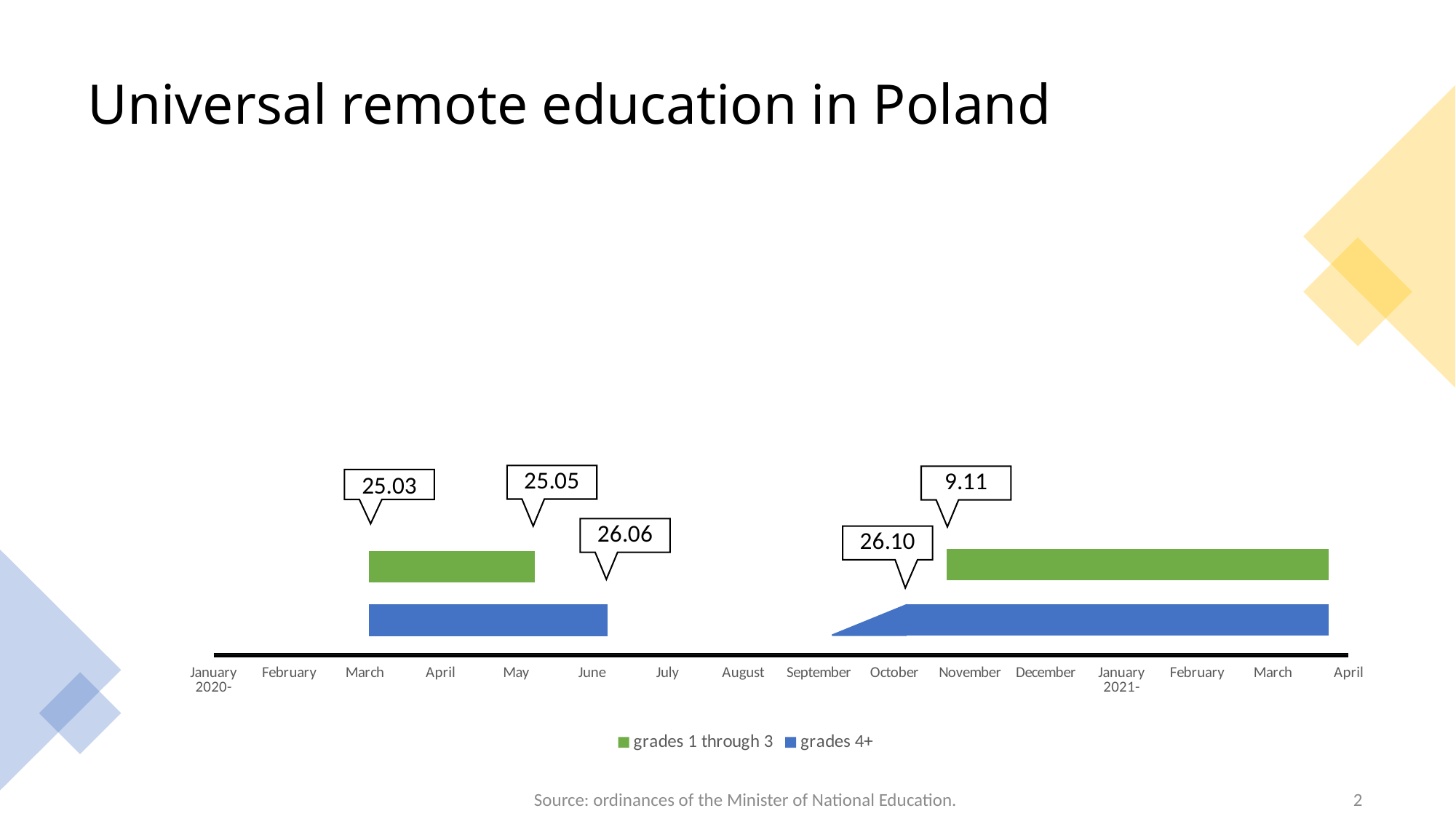
Which series' first remote-education period ends later, 'grades 1 through 3' or 'grades 4+'? grades 4+ What date label marks the start of the second 'grades 1 through 3' bar? 9.11 How many date callout labels are shown on the chart? 5 What are the two series named in the legend? grades 1 through 3; grades 4+ What date label marks the start of the second 'grades 4+' bar? 26.10 What date label marks the end of the first 'grades 4+' bar? 26.06 How many series does the legend list? 2 How many month labels are shown along the x axis? 16 What kind of chart is shown on the slide? Area chart What date label marks the start of the first 'grades 1 through 3' bar? 25.03 Which colour represents the 'grades 4+' series? Blue What date label marks the end of the first 'grades 1 through 3' bar? 25.05